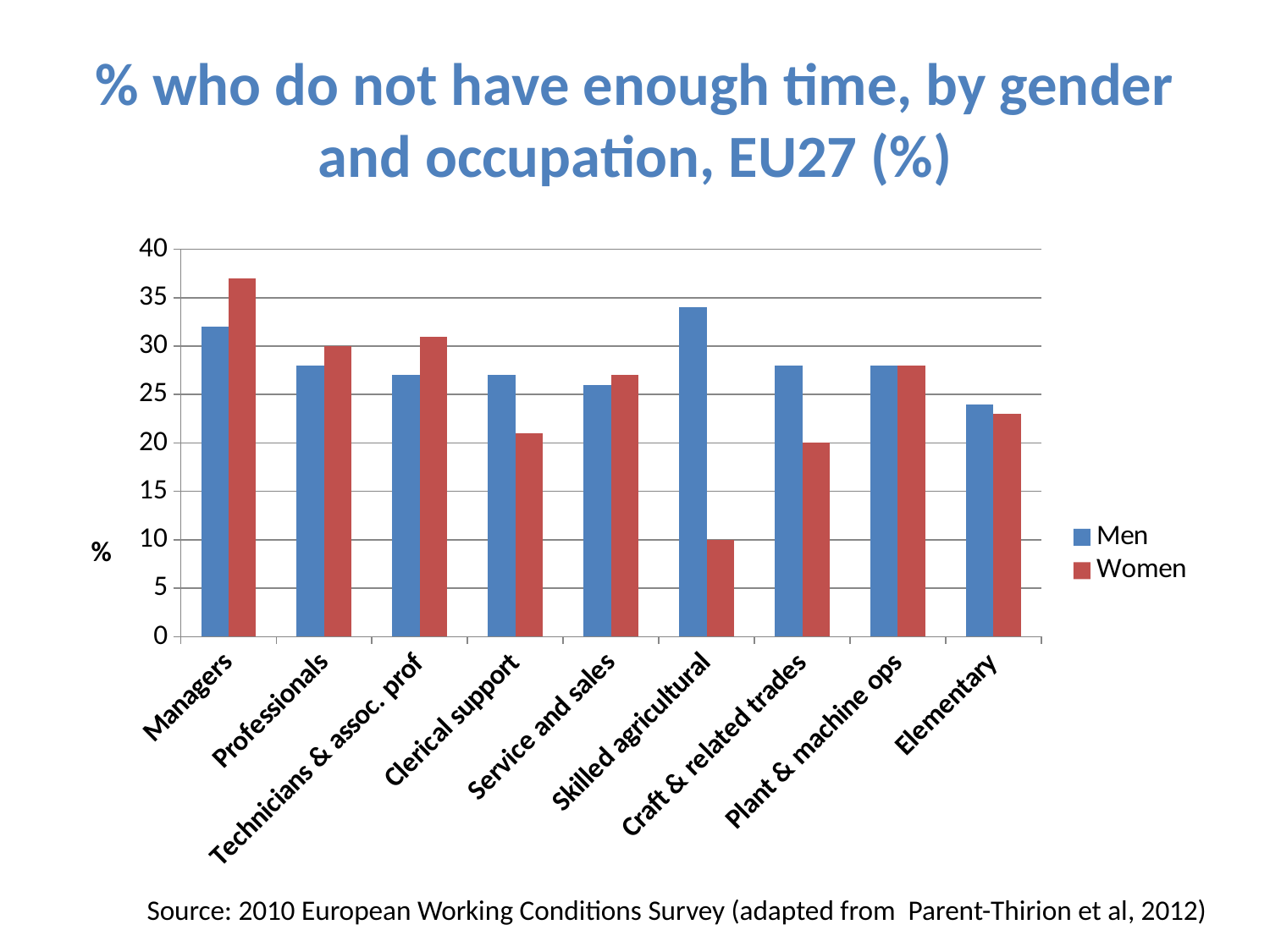
Is the value for Women in Clerical support greater or less than 25? less Which occupation has the highest value for Men? Skilled agricultural For Skilled agricultural, which is larger, the value for Men or for Women? Men How many occupation categories are shown on the x axis? 9 Is the value for Men in Managers greater or less than 30? greater What kind of chart is shown on the slide? Bar chart For Managers, which is larger, the value for Men or for Women? Women Which occupation has the highest value for Women? Managers How many series does the legend list? 2 Which occupation has the lowest value for Women? Skilled agricultural What are the two entries in the chart's legend? Men and Women What is the value for Women in Skilled agricultural? 10